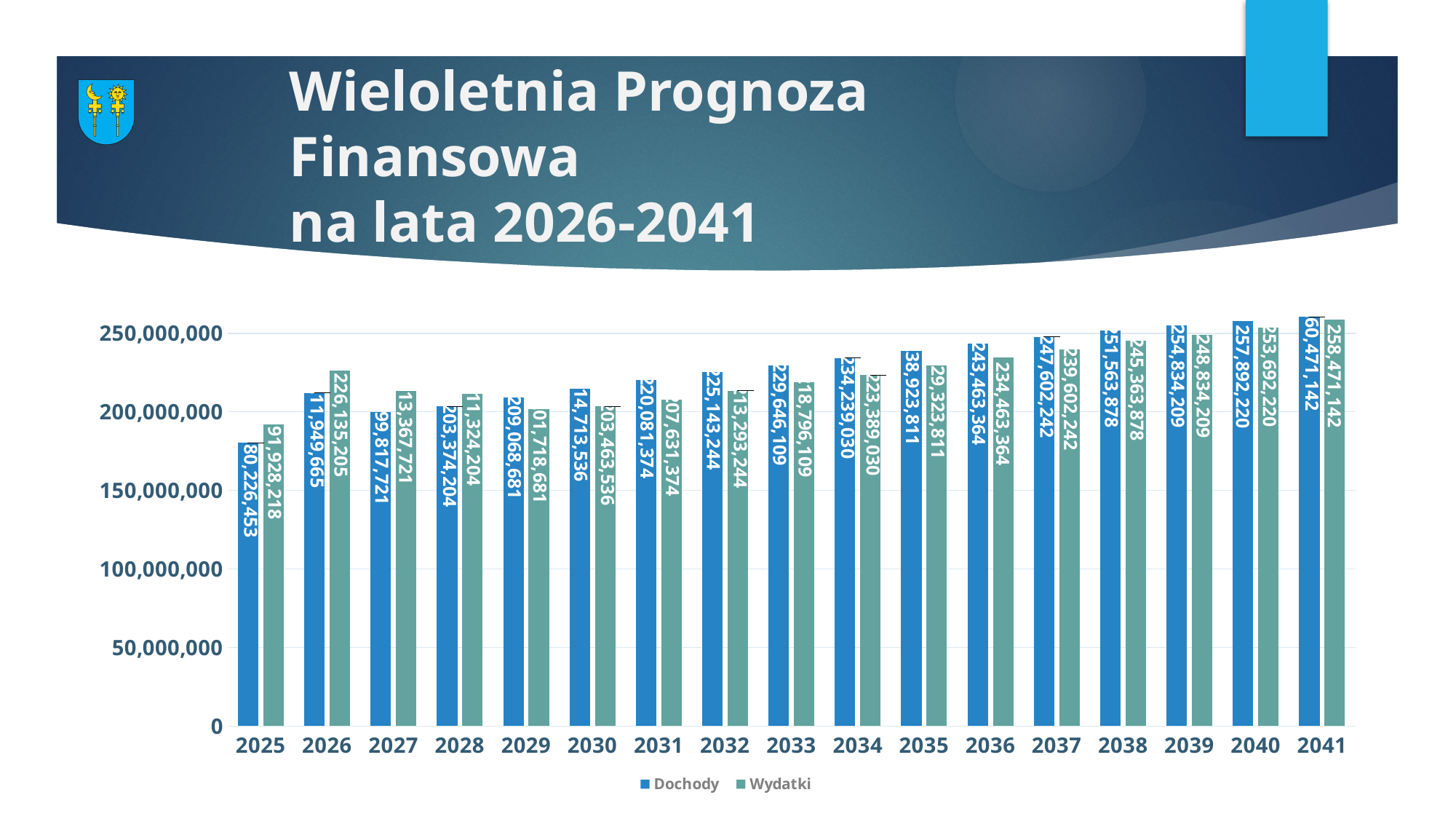
Which year has the lowest Wydatki value? 2025 What is the difference between Dochody and Wydatki in 2037? 8,000,000 How many years are shown on the x axis? 17 What is the Wydatki value for 2040? 253,692,220 How many series does the legend list? 2 Do the Dochody values rise or fall from 2025 to 2041? rise What is the Wydatki value for 2026? 226,135,205 What is the Dochody value for 2029? 209,068,681 In 2026, which is larger: Dochody or Wydatki? Wydatki What is the Dochody value for 2034? 234,239,030 Is the Dochody value for 2025 greater or less than 200,000,000? less Which year has the highest Dochody value? 2041